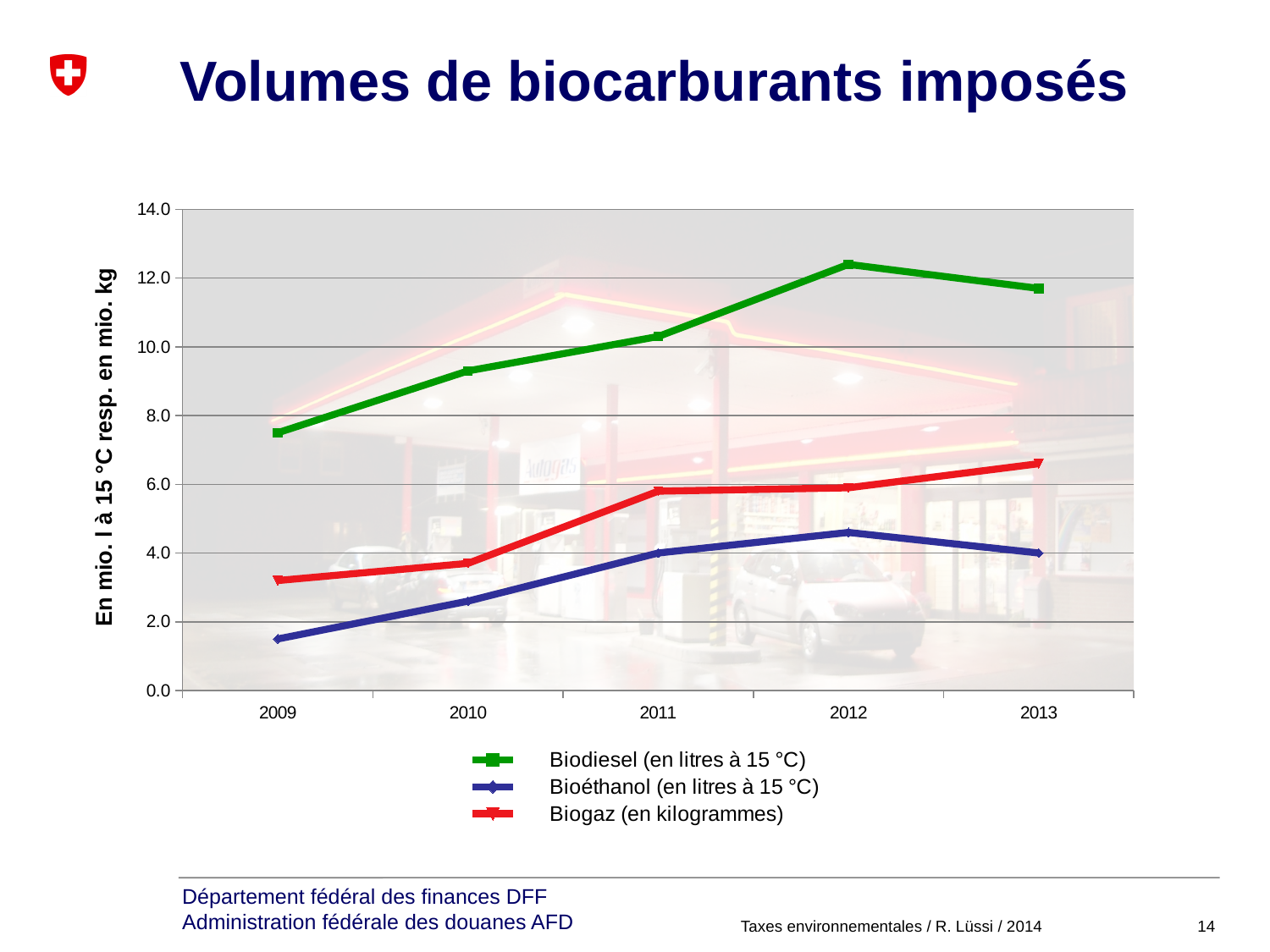
Is the Biogaz value for 2009 greater or less than 4.0? less In which year is the Biogaz value highest? 2013 Is the Biodiesel value for 2012 greater or less than 12.0? greater How many years are plotted along the x axis? 5 How many series does the legend list? 3 In which year is the Bioéthanol value lowest? 2009 Does the Biogaz series rise or fall from 2009 to 2013? rises What colour is the Biodiesel line? green In which year is the Biodiesel value highest? 2012 In 2013, which is larger: the Biogaz value or the Bioéthanol value? Biogaz Is the Bioéthanol value for 2009 greater or less than 2.0? less What kind of chart is shown on the slide? line chart